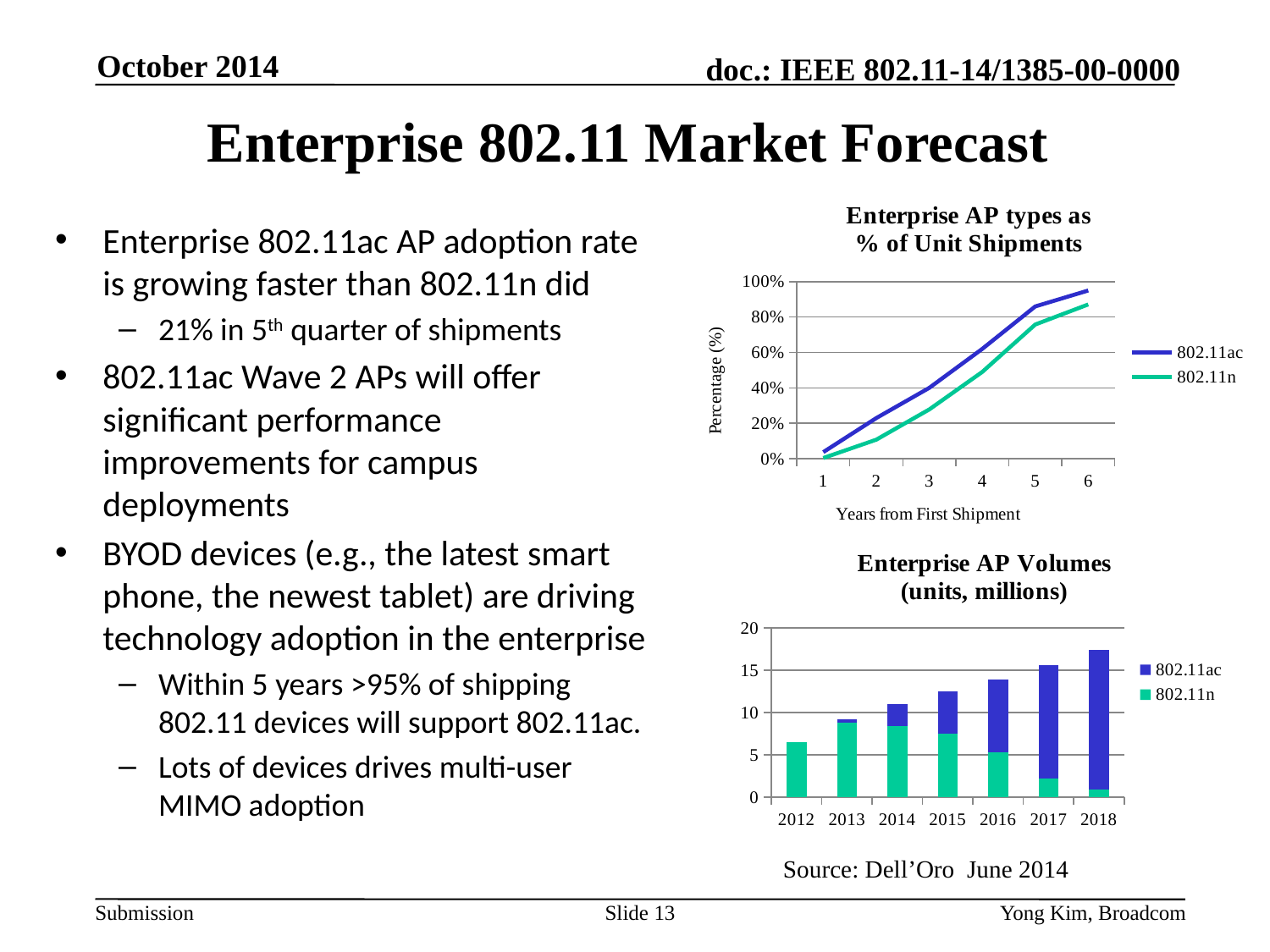
How many series does the legend of the 'Enterprise AP types as % of Unit Shipments' chart list? 2 In the 'Enterprise AP Volumes (units, millions)' chart, is the total bar height for 2018 greater or less than 15? greater In the 'Enterprise AP types as % of Unit Shipments' chart, is the 802.11ac value at year 1 greater or less than 20%? less In the 'Enterprise AP types as % of Unit Shipments' chart, does the 802.11ac line rise or fall from year 1 to year 6? rise In the 'Enterprise AP Volumes (units, millions)' chart, which year has the tallest total bar? 2018 What type of chart is the 'Enterprise AP types as % of Unit Shipments' chart? line chart In the 'Enterprise AP types as % of Unit Shipments' chart, is the 802.11n value at year 5 greater or less than 80%? less What type of chart is the 'Enterprise AP Volumes (units, millions)' chart? bar chart How many years are shown on the x axis of the 'Enterprise AP Volumes (units, millions)' chart? 7 In the 'Enterprise AP types as % of Unit Shipments' chart, which series is higher at year 4, 802.11ac or 802.11n? 802.11ac